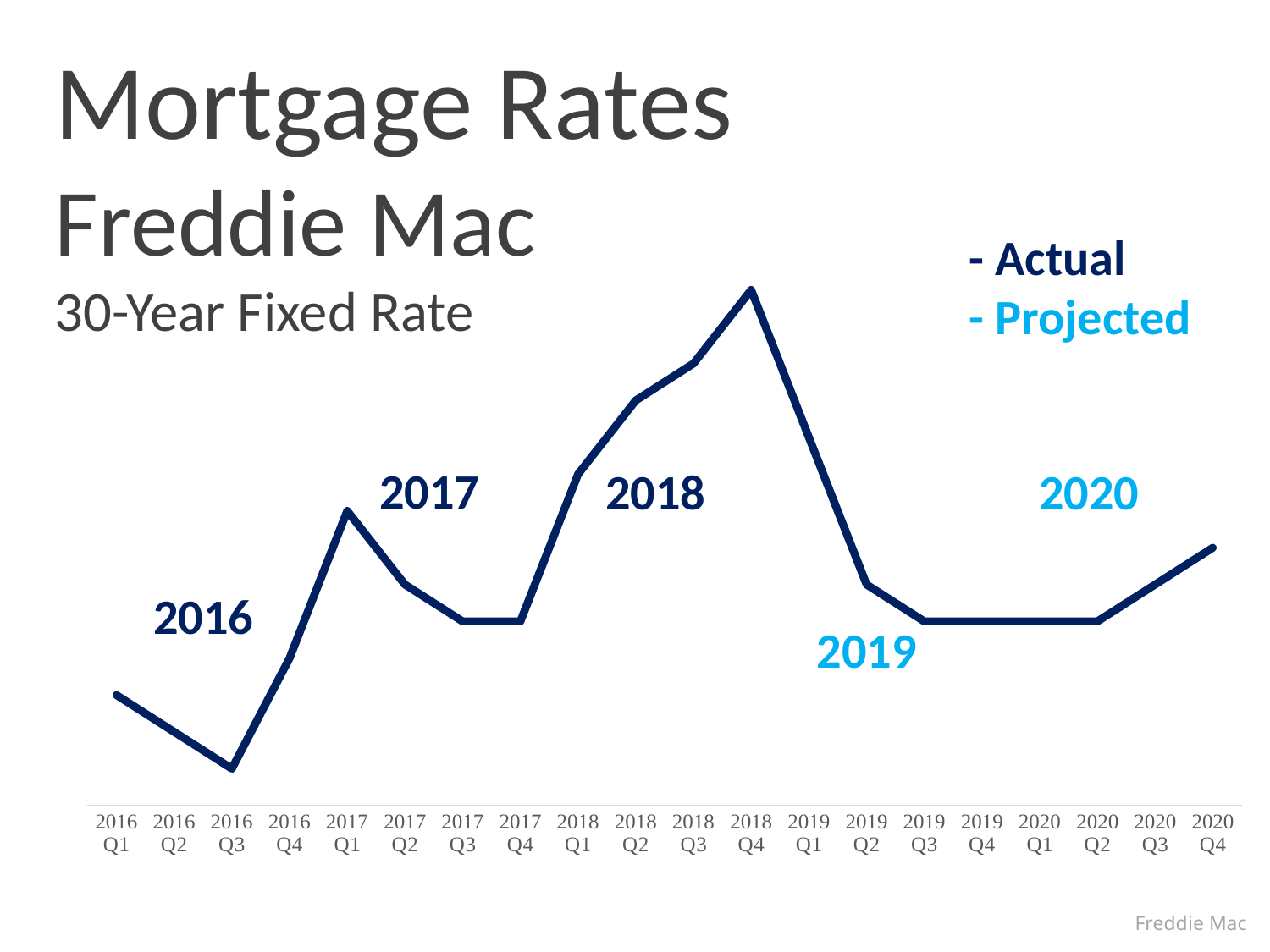
Does the line rise or fall from 2018 Q4 to 2019 Q2? Fall How many quarterly points are plotted along the x axis? 20 What kind of chart is shown on the slide? Line chart Does the line rise or fall from 2016 Q1 to 2016 Q3? Fall Which quarter has the highest mortgage rate on the chart? 2018 Q4 Does the line rise or fall from 2017 Q4 to 2018 Q4? Rise Which is higher, the rate in 2020 Q4 or the rate in 2020 Q2? 2020 Q4 What is the subtitle describing the rate type shown on the chart? 30-Year Fixed Rate Which is higher, the rate in 2018 Q4 or the rate in 2019 Q2? 2018 Q4 Which quarter has the lowest mortgage rate on the chart? 2016 Q3 Which is higher, the rate in 2017 Q1 or the rate in 2016 Q1? 2017 Q1 What are the two entries in the chart's legend? Actual and Projected